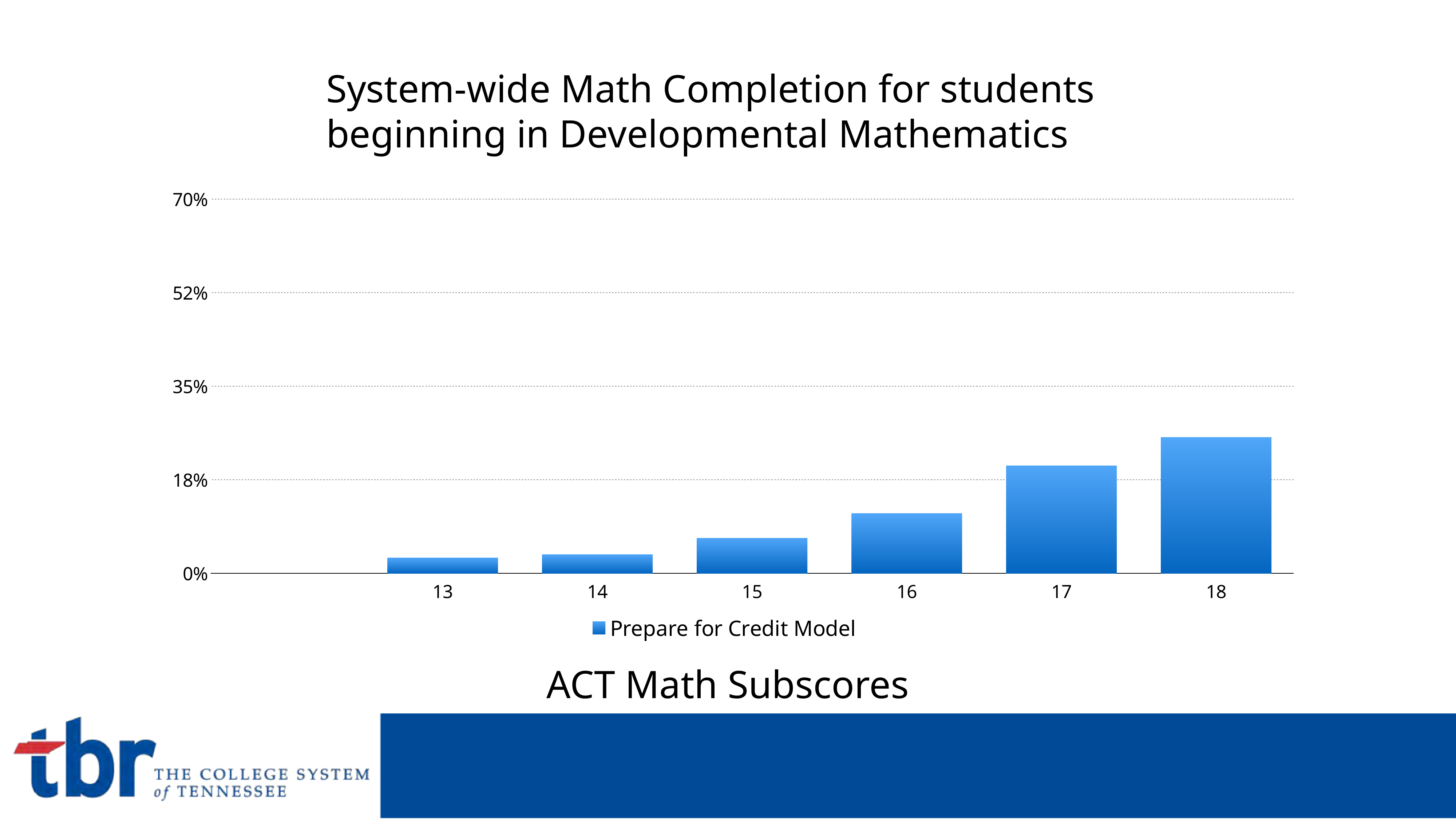
What label is given to the x axis of the chart? ACT Math Subscores How many ACT Math Subscore categories are plotted on the chart? 6 Do the completion rates rise or fall as the ACT Math Subscore increases from 13 to 18? rise Is the value for ACT Math Subscore 13 greater or less than 18%? less Is the value for ACT Math Subscore 18 greater or less than 35%? less Is the value for ACT Math Subscore 18 greater or less than 18%? greater Which ACT Math Subscore has the highest completion rate? 18 Which has a larger completion rate, ACT Math Subscore 16 or 17? 17 How many series does the legend list? 1 What is the name of the series shown in the legend? Prepare for Credit Model What kind of chart is shown on the slide? bar chart